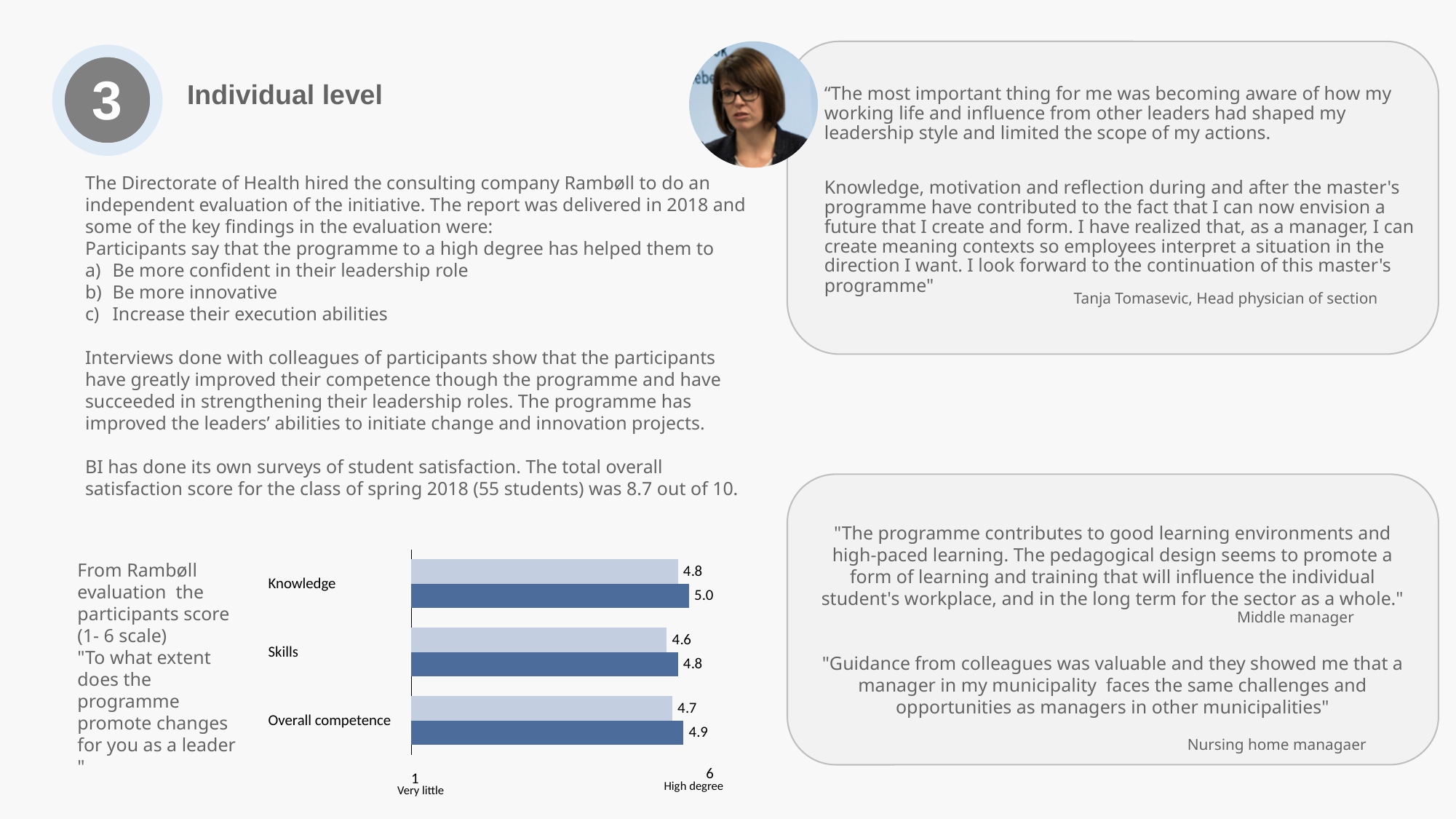
How many categories does the bar chart show? 3 Which category has the lowest light blue bar value? Skills What is the difference between the dark blue bar values for Knowledge and Skills? 0.2 What is the difference between the dark blue and light blue bar values for Skills? 0.2 Which is larger for Overall competence, the light blue bar or the dark blue bar? the dark blue bar What is the value of the light blue bar for Knowledge? 4.8 What is the value of the dark blue bar for Knowledge? 5.0 What is the value of the dark blue bar for Overall competence? 4.9 What label is shown at the right end of the chart's scale? 6 High degree What kind of chart is shown on the slide? bar chart What is the value of the light blue bar for Skills? 4.6 Which category has the highest dark blue bar value? Knowledge